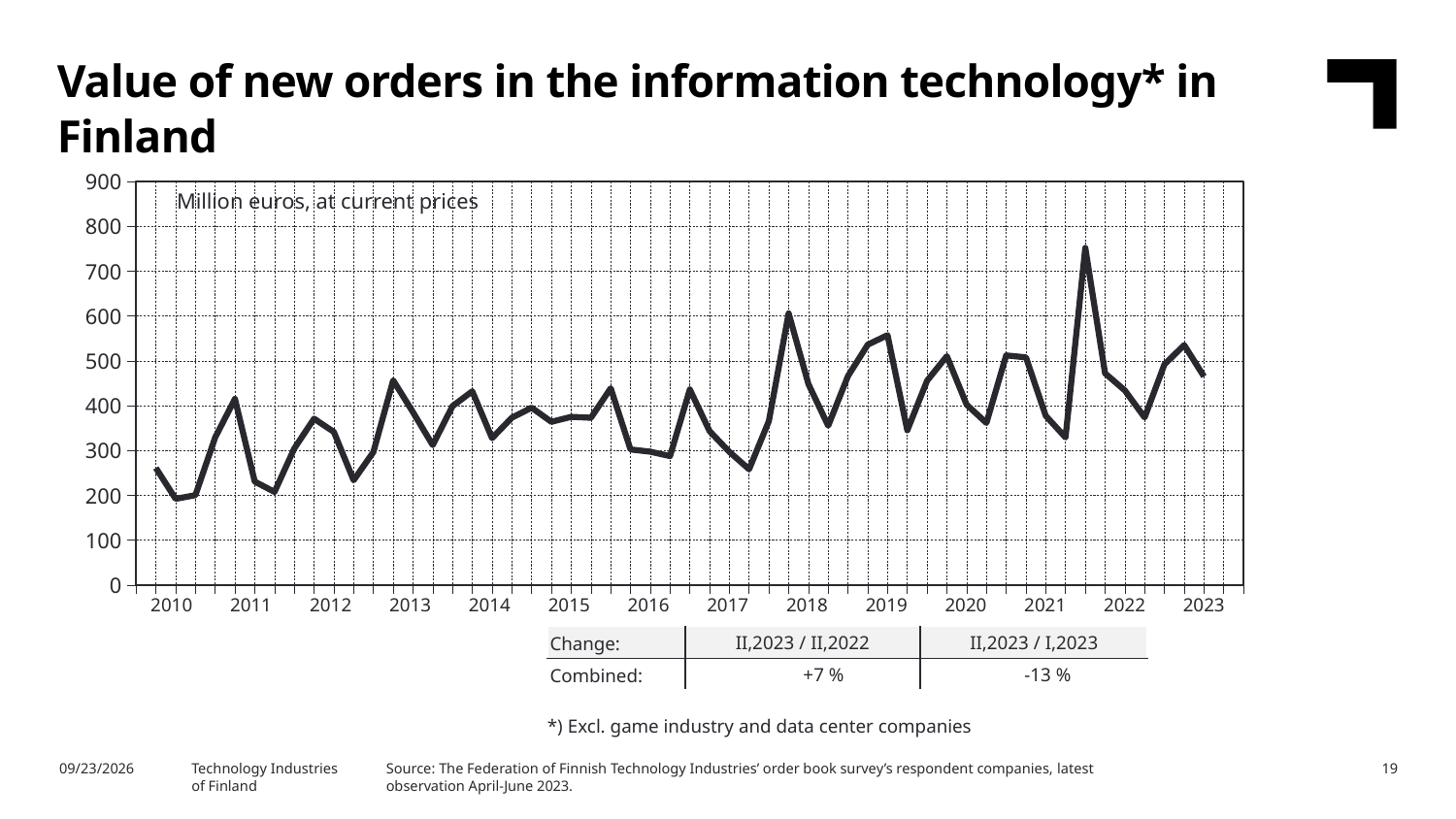
Is the peak value reached in 2018 greater or less than 500? greater According to the table below the chart, what is the combined change for II,2023 / I,2023? -13 % Is the lowest value in 2010 greater or less than 300? less Is the peak value in 2021 larger than the peak value in 2018? yes In which year does the line reach its highest peak? 2021 What is the title of the chart? Value of new orders in the information technology* in Finland Is the highest peak of the line, in 2021, greater or less than 700? greater In what unit are the values on the chart expressed, according to the label inside the plot area? Million euros, at current prices How many years are labelled on the x axis of the chart? 14 What kind of chart is shown on the slide? line chart Overall, do the values rise or fall from 2010 to 2023? rise